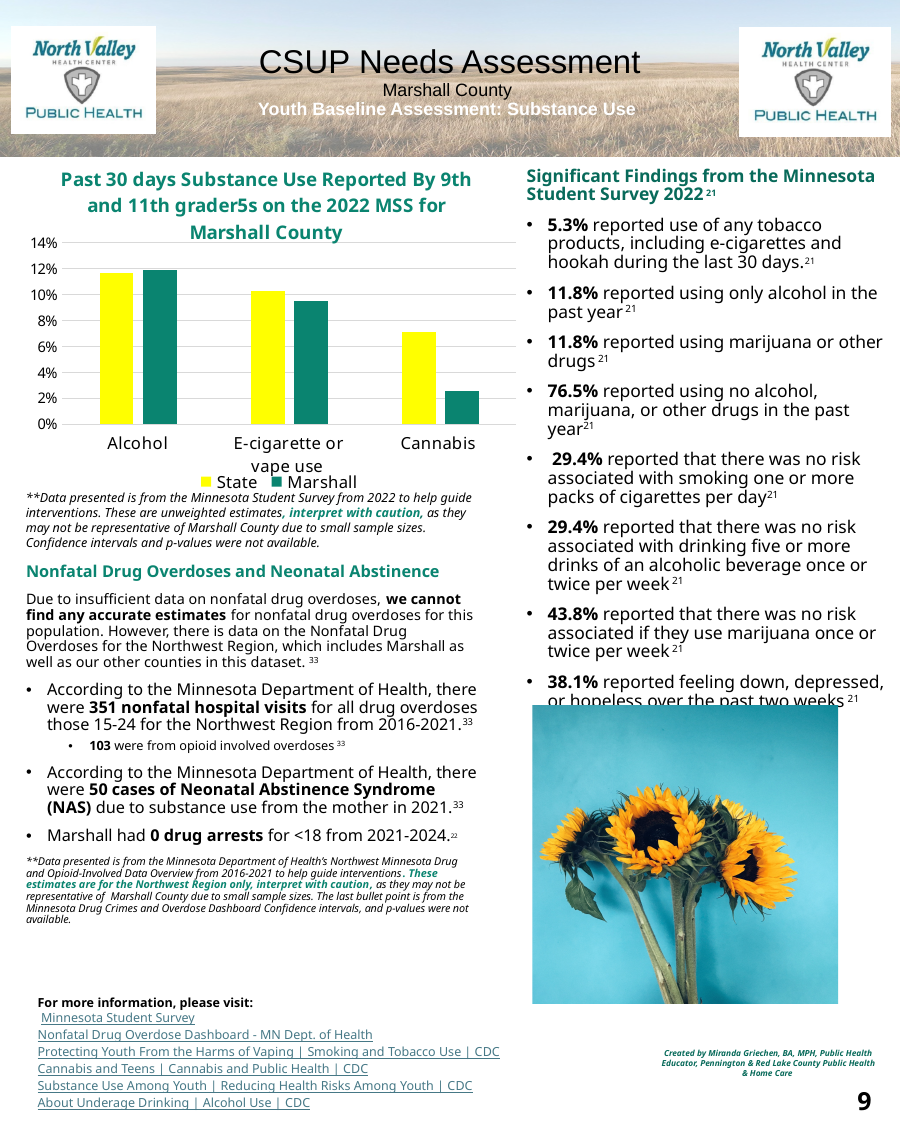
Which two series are listed in the chart's legend? State and Marshall For the Marshall series, which category has the highest value? Alcohol Is the Marshall value for Cannabis greater or less than 4%? less What colour are the Marshall bars in the chart? green Is the State value for Alcohol greater or less than 10%? greater Do the State values rise or fall moving from Alcohol to Cannabis along the x axis? fall How many substance categories are shown on the x axis of the chart? 3 How many series does the chart's legend list? 2 For the Marshall series, which category has the lowest value? Cannabis For the State series, which category has the lowest value? Cannabis For Cannabis, which is larger: the State value or the Marshall value? State What kind of chart is shown on the slide? bar chart